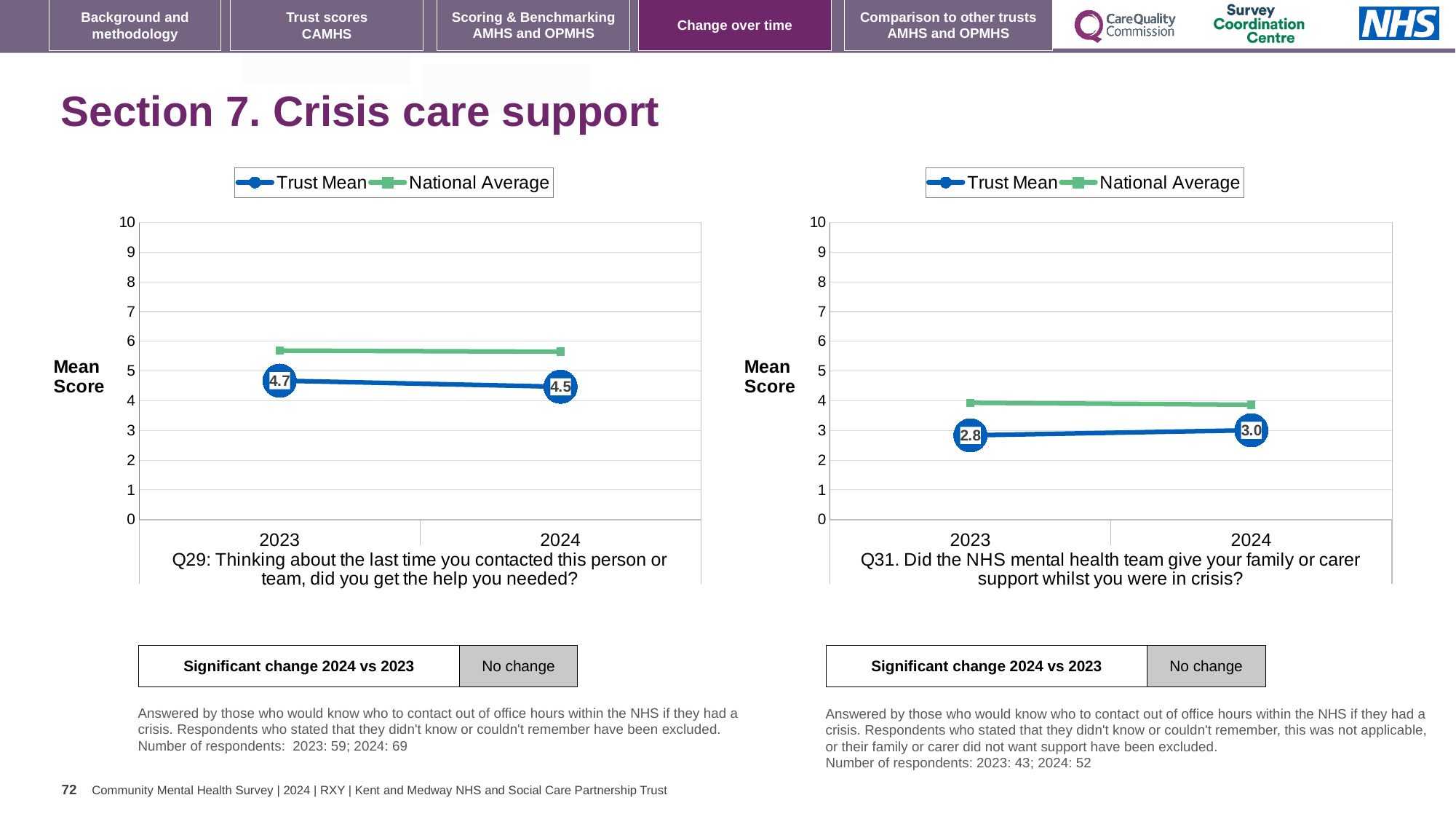
In the Q29 chart on the left, what is the Trust Mean for 2024? 4.5 In the Q29 chart on the left, which series is higher in 2024, Trust Mean or National Average? National Average What kind of chart is the Q29 chart on the left? line chart In the Q29 chart on the left, by how much did the Trust Mean change from 2023 to 2024? 0.2 In the Q29 chart on the left, what is the Trust Mean for 2023? 4.7 In the Q31 chart on the right, what is the Trust Mean for 2024? 3.0 In the Q31 chart on the right, does the Trust Mean rise or fall from 2023 to 2024? rise In the Q29 chart on the left, is the National Average for 2023 greater or less than 6? less How many series does the legend of the Q31 chart on the right list? 2 In the Q31 chart on the right, what is the Trust Mean for 2023? 2.8 In the Q29 chart on the left, does the Trust Mean rise or fall from 2023 to 2024? fall In the Q31 chart on the right, is the National Average for 2023 greater or less than 3? greater